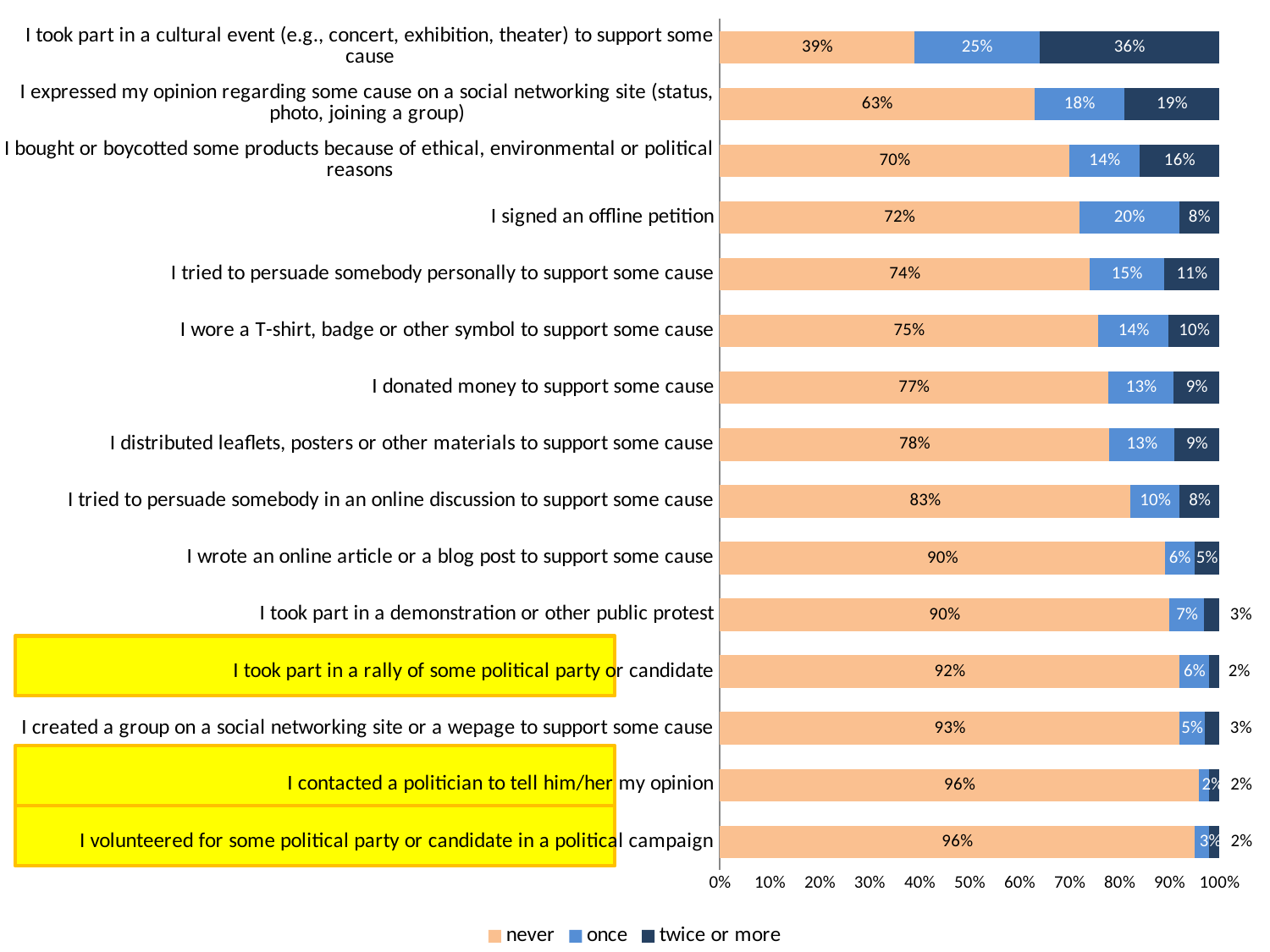
Which series is shown in the dark navy colour in the legend? twice or more How many series does the legend list? 3 What is the difference in percentage points between the "never" values for "I donated money to support some cause" and "I took part in a cultural event"? 38 percentage points What percentage of respondents answered "never" for "I signed an offline petition"? 72% What is the total of the stacked bar for "I bought or boycotted some products because of ethical, environmental or political reasons"? 100% Which has a larger "once" value: "I signed an offline petition" or "I wore a T-shirt, badge or other symbol to support some cause"? I signed an offline petition What kind of chart is shown on the slide? Stacked bar chart Which activity has the highest "twice or more" percentage? I took part in a cultural event (e.g., concert, exhibition, theater) to support some cause Which activity has the lowest "never" percentage? I took part in a cultural event (e.g., concert, exhibition, theater) to support some cause What is the "once" value for "I expressed my opinion regarding some cause on a social networking site (status, photo, joining a group)"? 18% How many activities (categories) are shown in the chart? 15 What is the "twice or more" value for "I took part in a cultural event (e.g., concert, exhibition, theater) to support some cause"? 36%